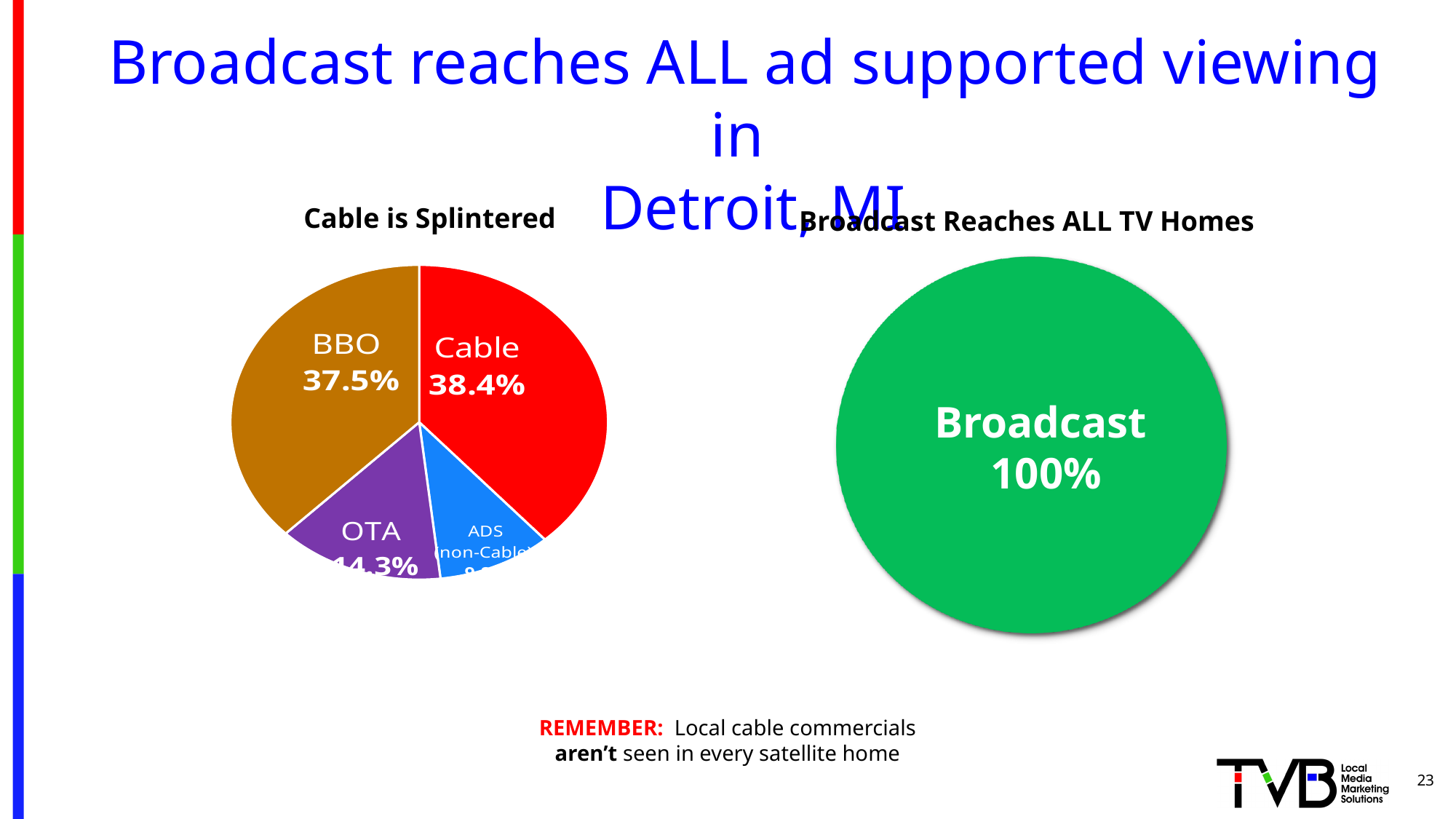
In the "Cable is Splintered" pie chart, what share is shown for BBO? 37.5% In the "Broadcast Reaches ALL TV Homes" chart, what percentage is shown for Broadcast? 100% How many slices does the "Cable is Splintered" pie chart have? 4 In the "Cable is Splintered" pie chart, which is larger, BBO or OTA? BBO In the "Cable is Splintered" pie chart, what share is shown for OTA? 14.3% What is the title of the pie chart on the left side of the slide? Cable is Splintered In the "Cable is Splintered" pie chart, which slice has the largest share? Cable In the "Cable is Splintered" pie chart, what share is shown for Cable? 38.4% In the "Cable is Splintered" pie chart, how much larger is the Cable share than the BBO share? 0.9% What is the title of the chart on the right side of the slide? Broadcast Reaches ALL TV Homes In the "Cable is Splintered" pie chart, which slice has the smallest share? ADS (non-Cable) What kind of chart is the "Cable is Splintered" chart? Pie chart